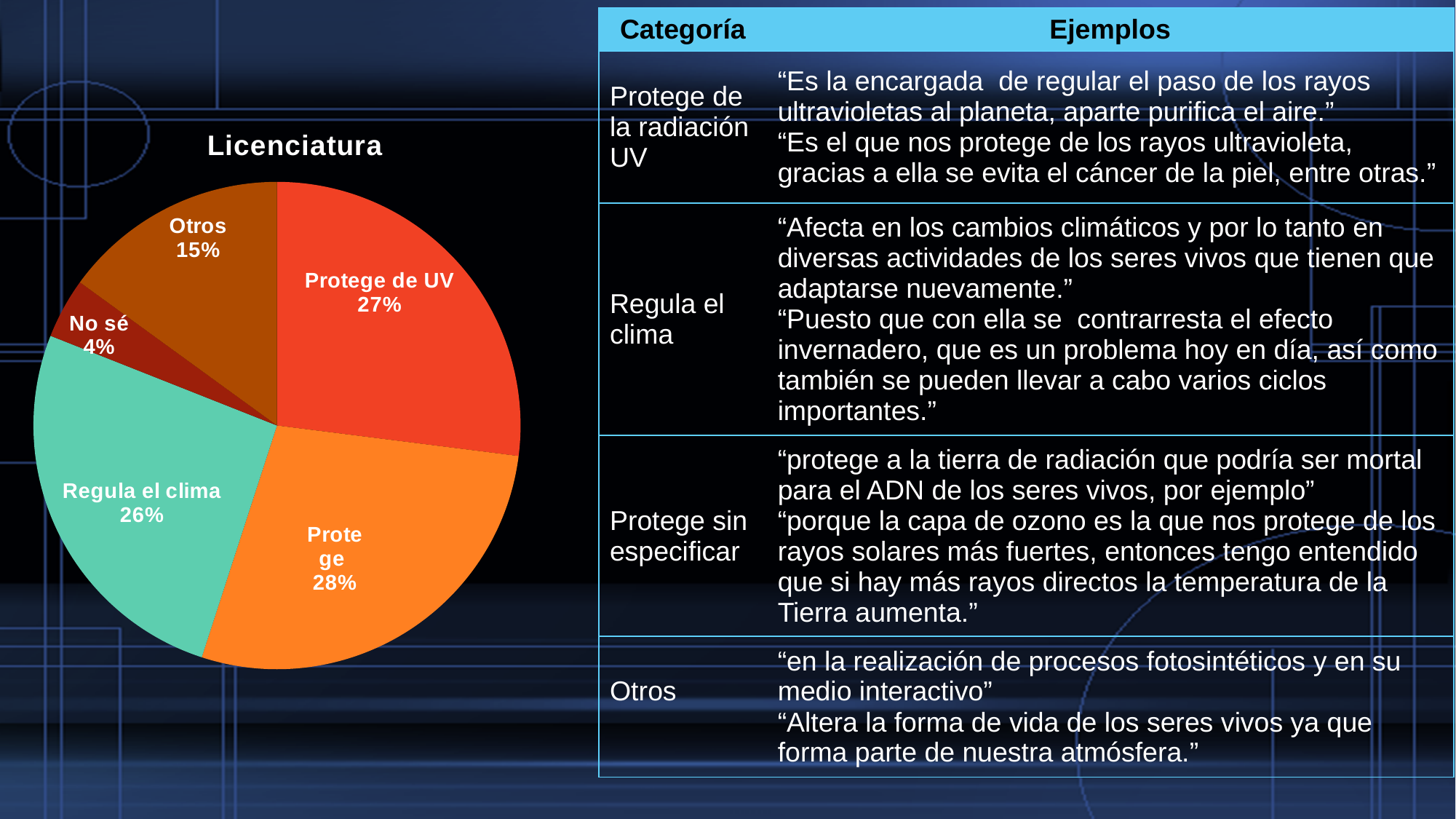
How many slices does the pie chart have? 5 Which category has the smallest share of the pie? No sé What is the difference in percentage points between 'Otros' and 'No sé'? 11 Which category has the largest share of the pie? Protege What percentage does the 'Protege' slice represent? 28% What percentage does the 'Protege de UV' slice represent? 27% What is the title of the chart? Licenciatura What percentage does the 'No sé' slice represent? 4% What type of chart is shown on the slide? pie chart What percentage does the 'Otros' slice represent? 15% Which is larger, the 'Regula el clima' slice or the 'Otros' slice? Regula el clima What percentage does the 'Regula el clima' slice represent? 26%